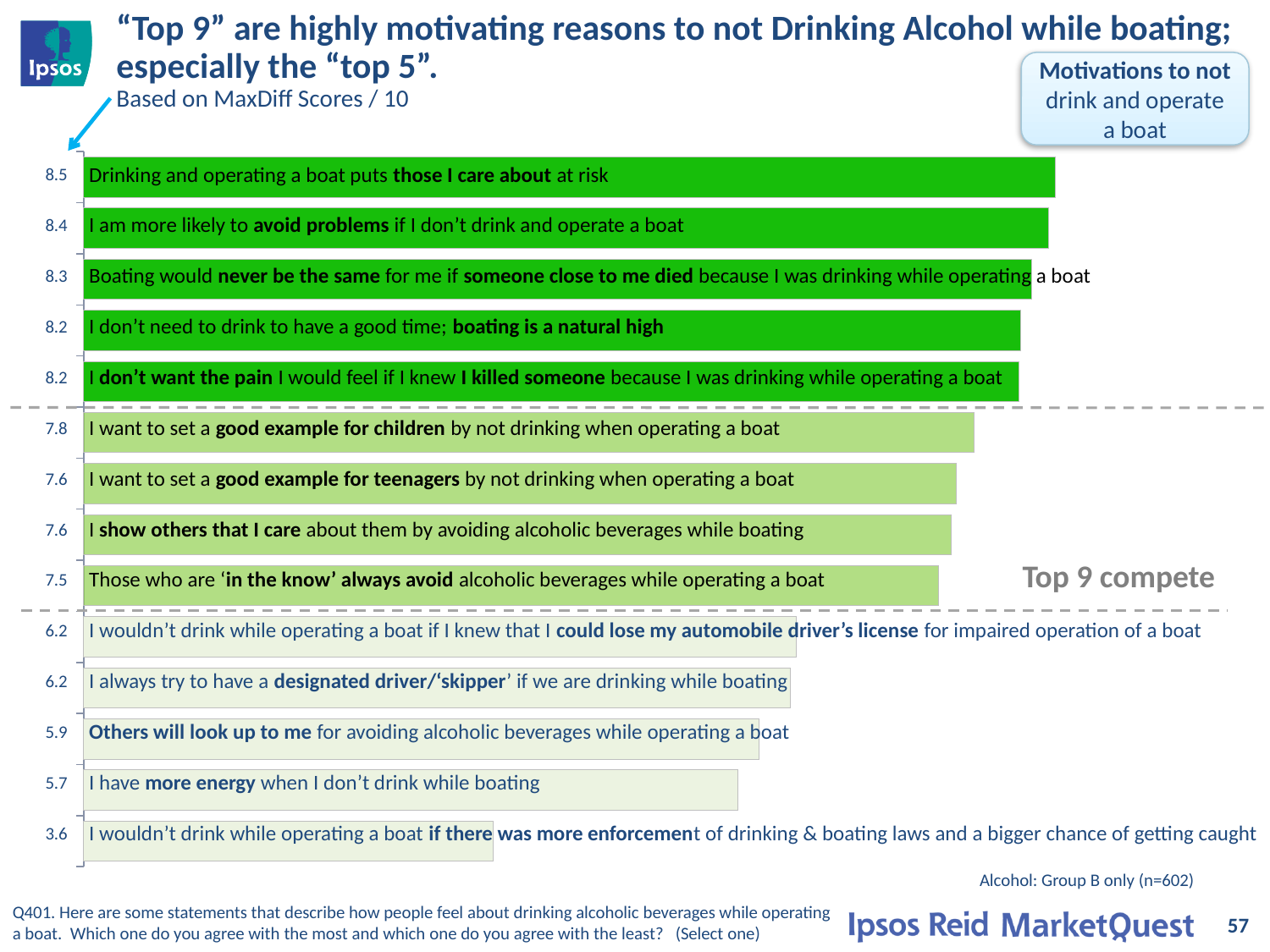
What is the difference in MaxDiff score between "I am more likely to avoid problems if I don't drink and operate a boat" and "Others will look up to me for avoiding alcoholic beverages while operating a boat"? 2.5 How many statements are plotted in the chart? 14 Which has a higher MaxDiff score: "I don't need to drink to have a good time; boating is a natural high" or "Those who are 'in the know' always avoid alcoholic beverages while operating a boat"? I don't need to drink to have a good time; boating is a natural high Which statement has the highest MaxDiff score? Drinking and operating a boat puts those I care about at risk Which statement has the lowest MaxDiff score? I wouldn't drink while operating a boat if there was more enforcement of drinking & boating laws and a bigger chance of getting caught What is the MaxDiff score for "Drinking and operating a boat puts those I care about at risk"? 8.5 What is the MaxDiff score for "I always try to have a designated driver/'skipper' if we are drinking while boating"? 6.2 Do the MaxDiff scores increase or decrease going from the top bar to the bottom bar? Decrease What is the difference between the highest score (8.5) and the lowest score (3.6)? 4.9 What is the MaxDiff score for "I want to set a good example for children by not drinking when operating a boat"? 7.8 What type of chart is shown on the slide? Bar chart What is the MaxDiff score for "I have more energy when I don't drink while boating"? 5.7